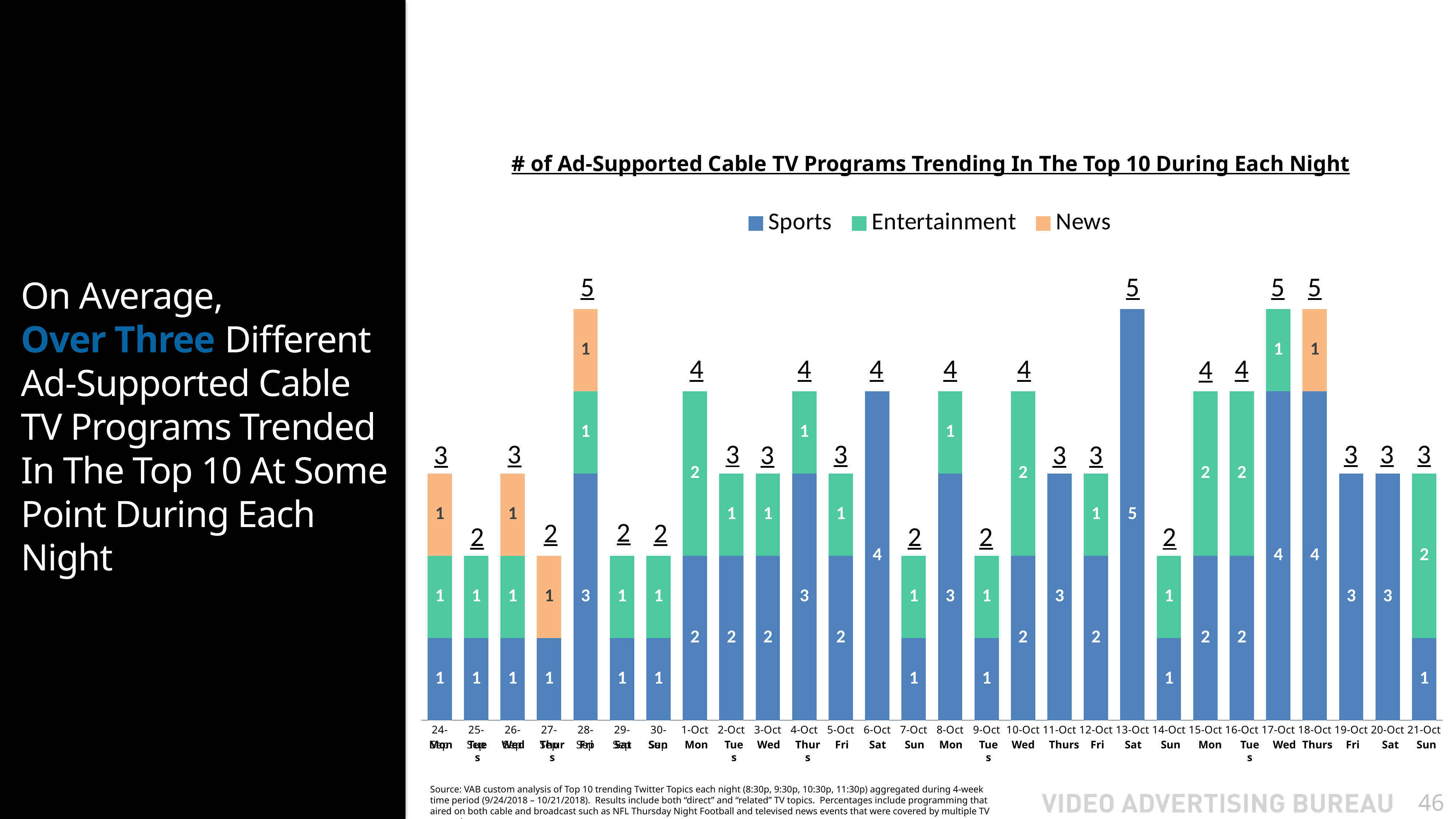
What is the total of the stacked bar for 1-Oct Mon? 4 What type of chart is shown on the slide? Stacked bar chart What is the difference between the Sports value on 17-Oct Wed and the Sports value on 24-Sep Mon? 3 What is the total of the stacked bar for 28-Sep Fri? 5 How many series does the legend list? 3 Which date has the highest Sports value? 13-Oct Sat Which has the larger Sports value, 6-Oct Sat or 11-Oct Thurs? 6-Oct Sat How many dates (bars) are plotted on the chart? 28 What is the Sports value for 13-Oct Sat? 5 What are the three legend entries of the chart? Sports, Entertainment, News What is the Entertainment value for 21-Oct Sun? 2 What is the News value for 18-Oct Thurs? 1